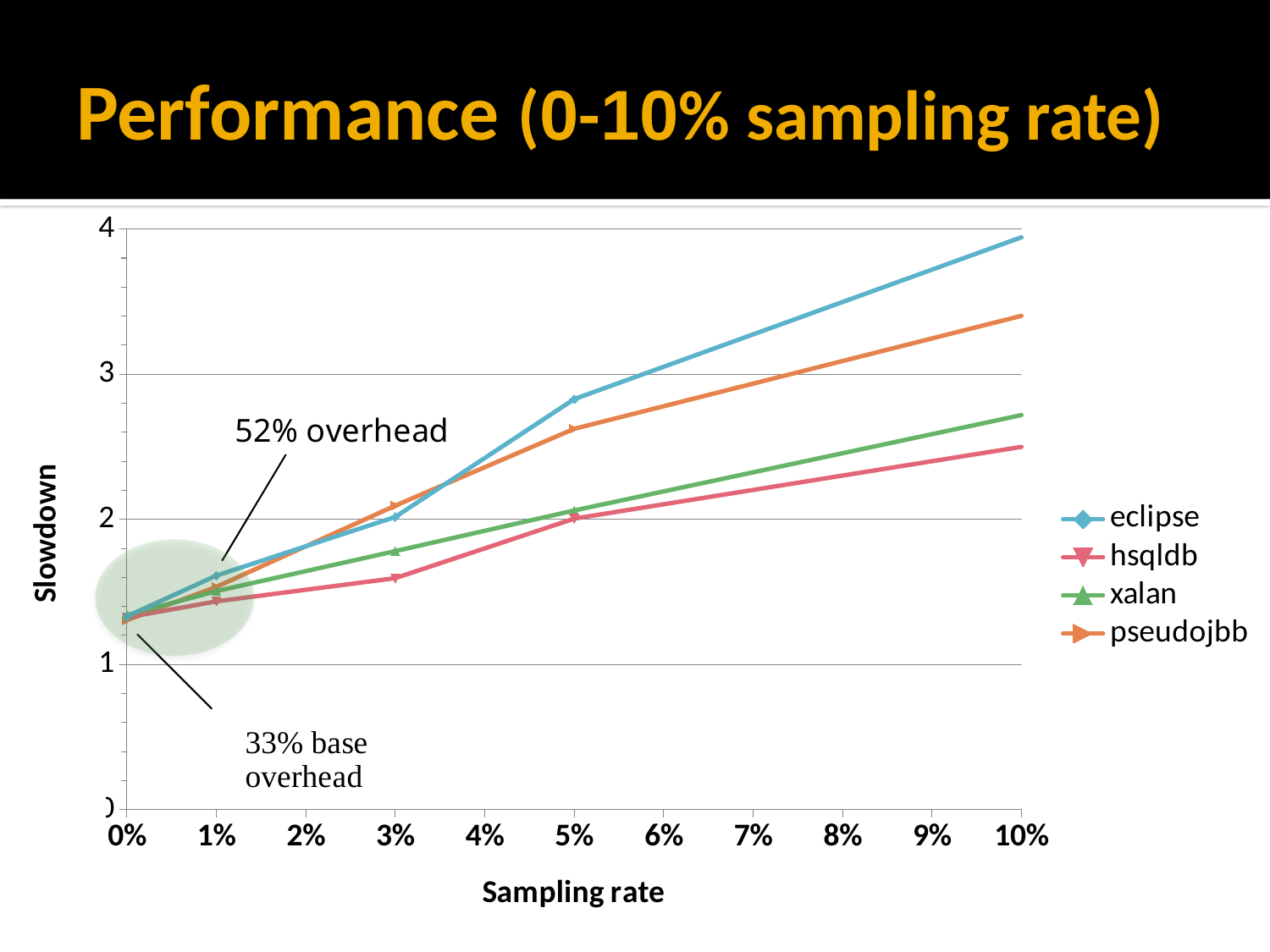
How many sampling rate values are labeled on the x axis? 11 Which series has the lowest slowdown at a 10% sampling rate? hsqldb At a 10% sampling rate, which series has the larger slowdown, eclipse or pseudojbb? eclipse At a 10% sampling rate, which series has the larger slowdown, xalan or hsqldb? xalan Does the slowdown for eclipse rise or fall as the sampling rate increases? rise Is the slowdown for hsqldb at a 10% sampling rate greater or less than 3? less What is the label of the y axis? Slowdown How many series does the legend list? 4 What kind of chart is shown on the slide? line chart Is the slowdown for eclipse at a 10% sampling rate greater or less than 3? greater Is the slowdown for hsqldb at a 3% sampling rate greater or less than 2? less Which series has the highest slowdown at a 10% sampling rate? eclipse